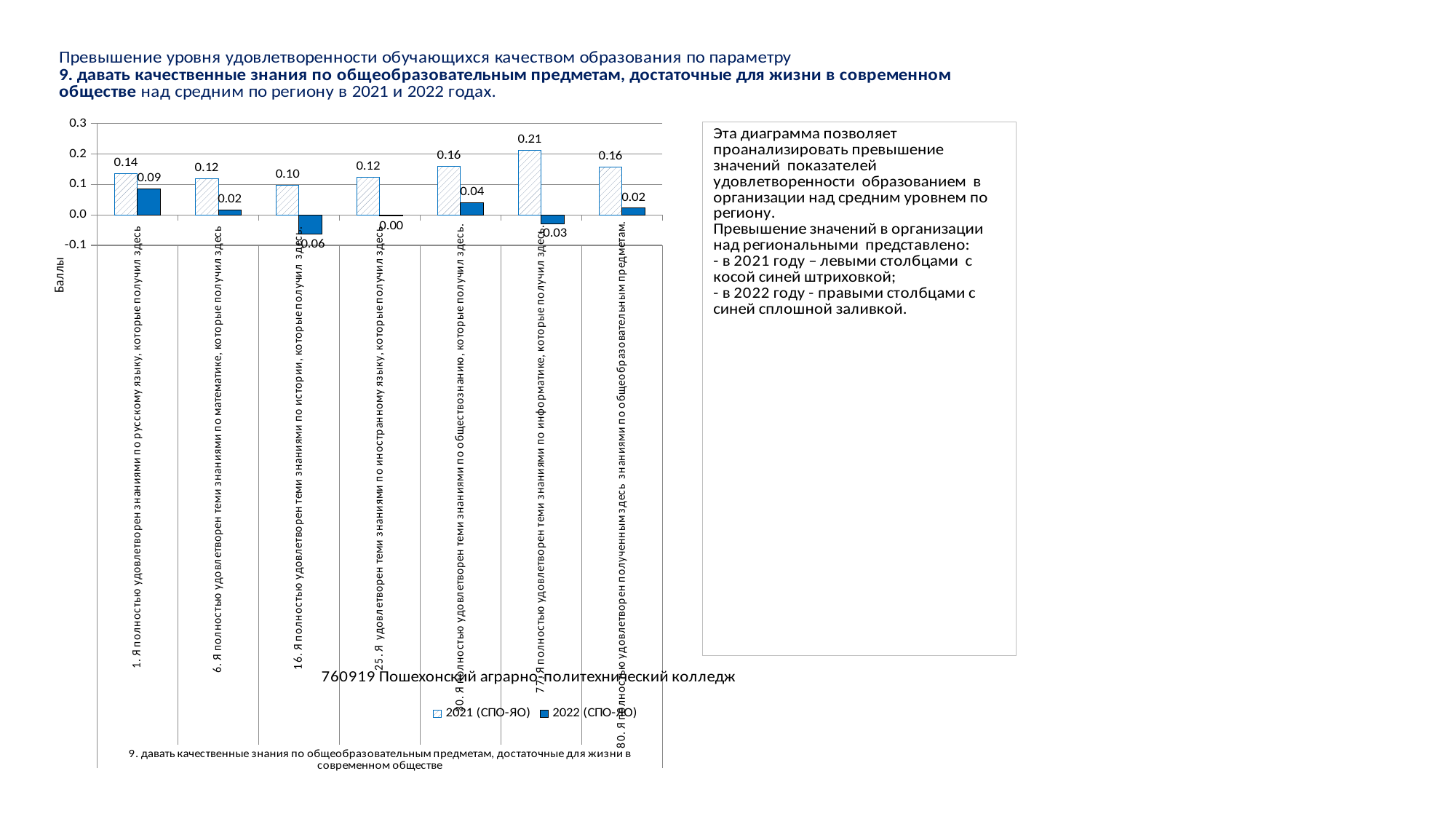
Which category has the lowest 2022 (СПО-ЯО) value? 16. Я полностью удовлетворен теми знаниями по истории, которые получил здесь What is the title of the chart? 760919 Пошехонский аграрно-политехнический колледж What is the 2022 (СПО-ЯО) value for the category about knowledge of history (category 16)? -0.06 What is the 2022 (СПО-ЯО) value for the category about knowledge of a foreign language (category 25)? 0.00 What is the difference between the 2021 and 2022 values for the category about knowledge of informatics (category 77)? 0.24 What is the label of the vertical axis of the chart? Баллы How many categories are shown on the x axis of the chart? 7 For the category about knowledge of mathematics (category 6), which is larger: the 2021 (СПО-ЯО) value or the 2022 (СПО-ЯО) value? 2021 (СПО-ЯО) What kind of chart is shown on the slide? Bar chart What is the 2021 (СПО-ЯО) value for the category about knowledge of the Russian language (category 1)? 0.14 Which category has the highest 2021 (СПО-ЯО) value? 77. Я полностью удовлетворен теми знаниями по информатике, которые получил здесь How many series does the legend list? 2